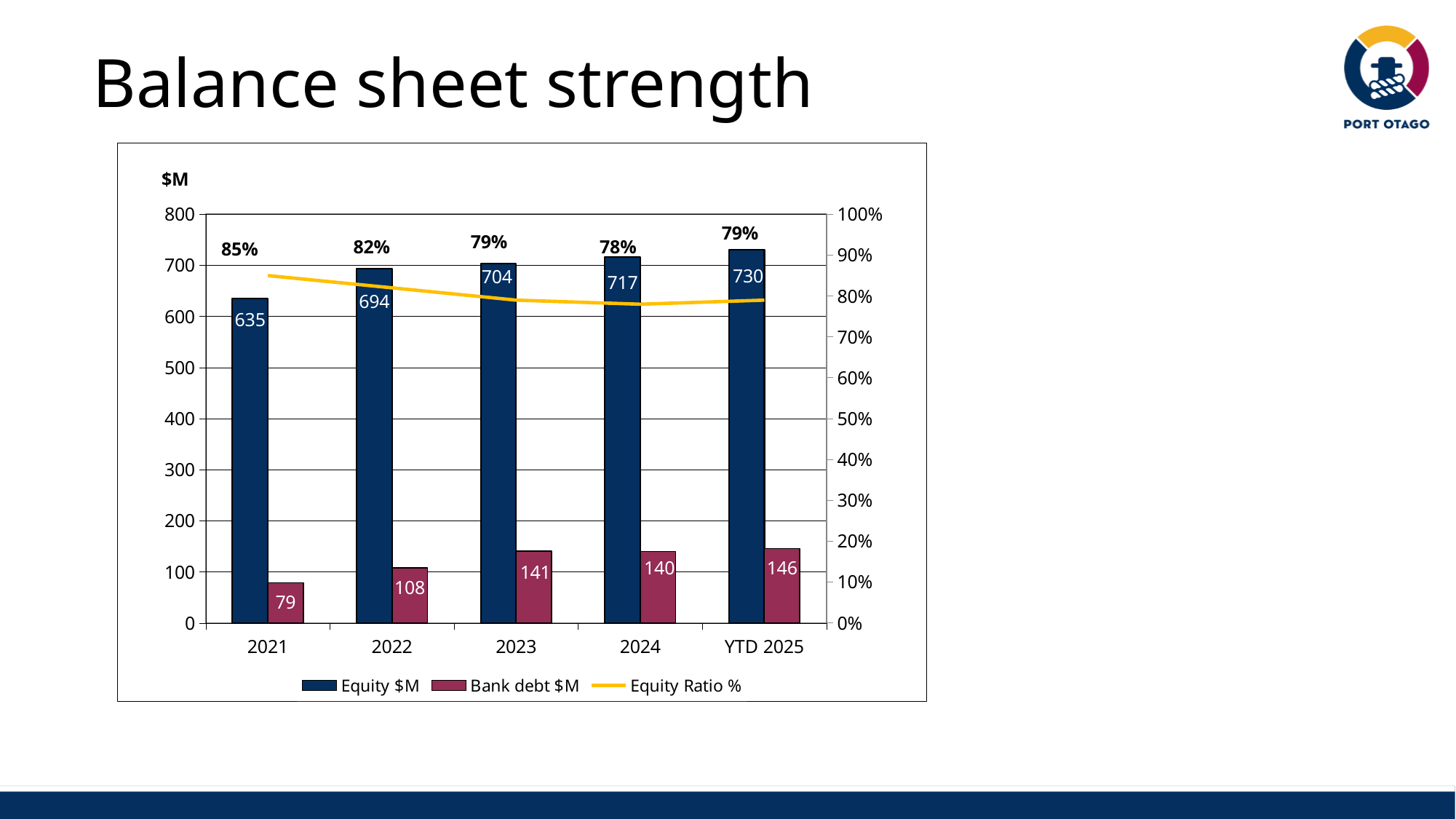
What is the difference between Equity $M in YTD 2025 and 2021? 95 How many years are shown on the x axis? 5 How many series does the legend list? 3 What is the Equity Ratio % for 2022? 82% Does the Equity $M series rise or fall from 2021 to YTD 2025? Rise What is the Equity $M value for 2023? 704 Which is larger, Bank debt $M in 2023 or in 2024? 2023 What is the Bank debt $M value for 2021? 79 Which year has the lowest Bank debt $M? 2021 What kind of chart is used for the Equity $M and Bank debt $M series? Bar chart Is the Equity $M value for 2021 greater or less than 600? greater Which year has the highest Equity $M? YTD 2025